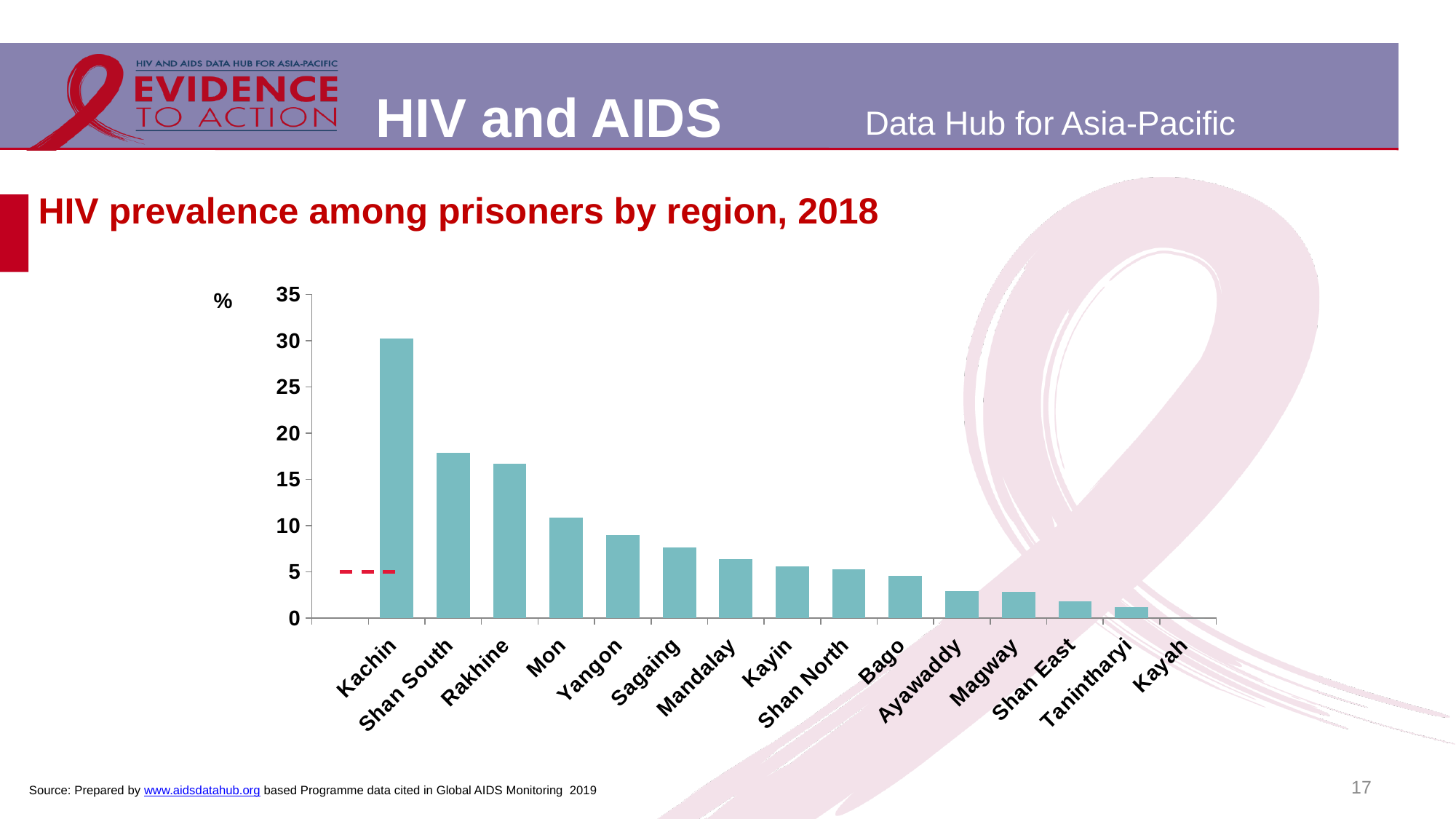
Is the value for Kachin greater or less than 25? greater What kind of chart is shown on the slide? bar chart Which region has the highest HIV prevalence among prisoners? Kachin Which has the larger value, Mon or Yangon? Mon Is the value for Shan South greater or less than 15? greater How many regions are shown on the x axis of the chart? 15 Do the bar values rise or fall moving from left to right along the x axis? fall What is the title of the chart? HIV prevalence among prisoners by region, 2018 Which has the larger value, Shan South or Rakhine? Shan South Is the value for Rakhine greater or less than 20? less